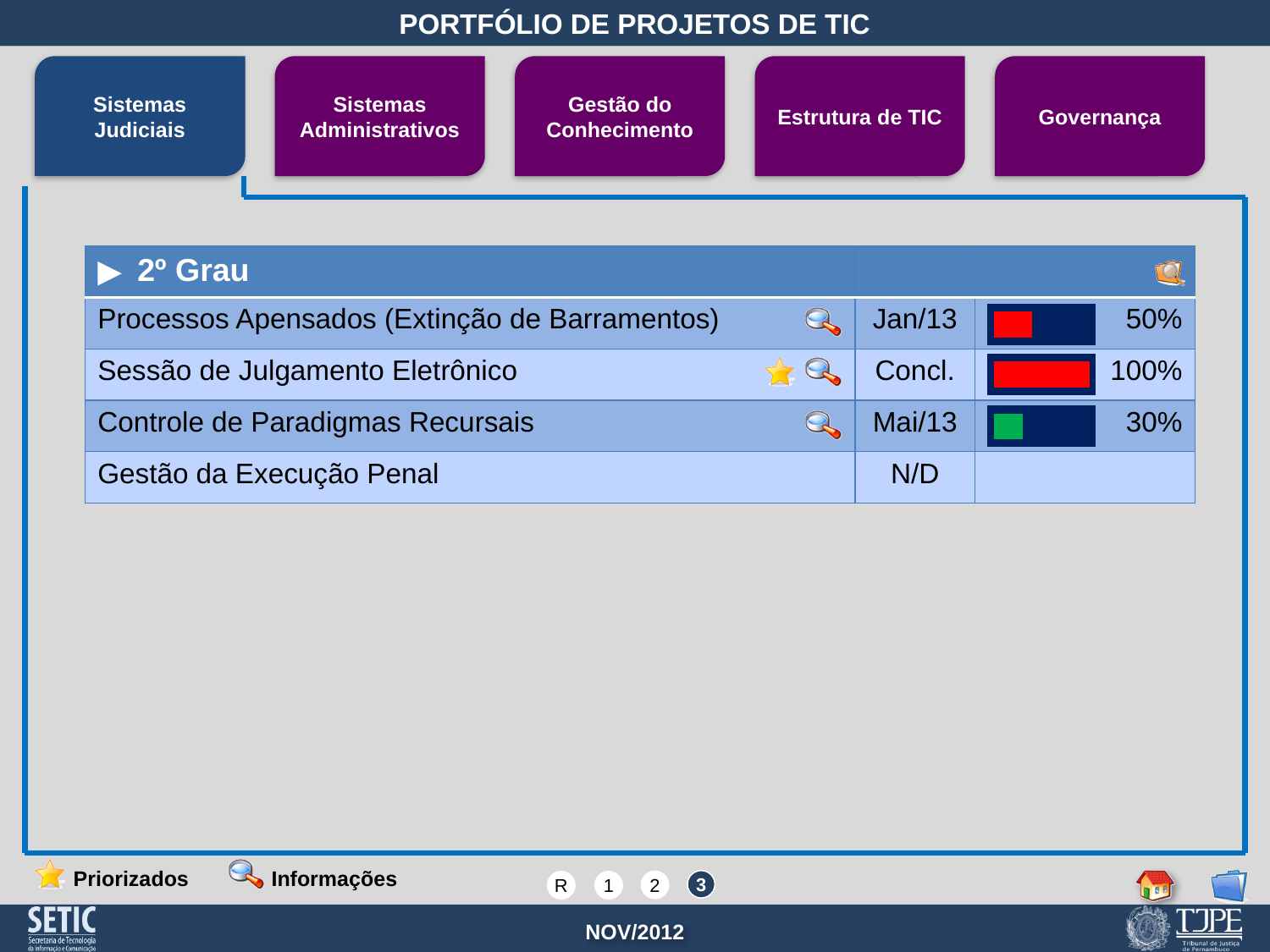
How many projects are listed in the 2º Grau table? 4 What is the completion percentage shown for Processos Apensados (Extinção de Barramentos)? 50% How many projects in the 2º Grau table have a progress bar shown? 3 What is the completion percentage shown for Controle de Paradigmas Recursais? 30% Which project in the 2º Grau table has the highest completion percentage? Sessão de Julgamento Eletrônico What is the completion percentage shown for Sessão de Julgamento Eletrônico? 100% Which has a higher completion percentage, Processos Apensados (Extinção de Barramentos) or Controle de Paradigmas Recursais? Processos Apensados (Extinção de Barramentos) Among the projects with a progress bar, which has the lowest completion percentage? Controle de Paradigmas Recursais What colour is the progress bar for Controle de Paradigmas Recursais? Green What is the difference in completion percentage between Sessão de Julgamento Eletrônico and Processos Apensados (Extinção de Barramentos)? 50% What kind of chart is used to show project progress in the table? Bar chart What is the difference in completion percentage between Processos Apensados (Extinção de Barramentos) and Controle de Paradigmas Recursais? 20%